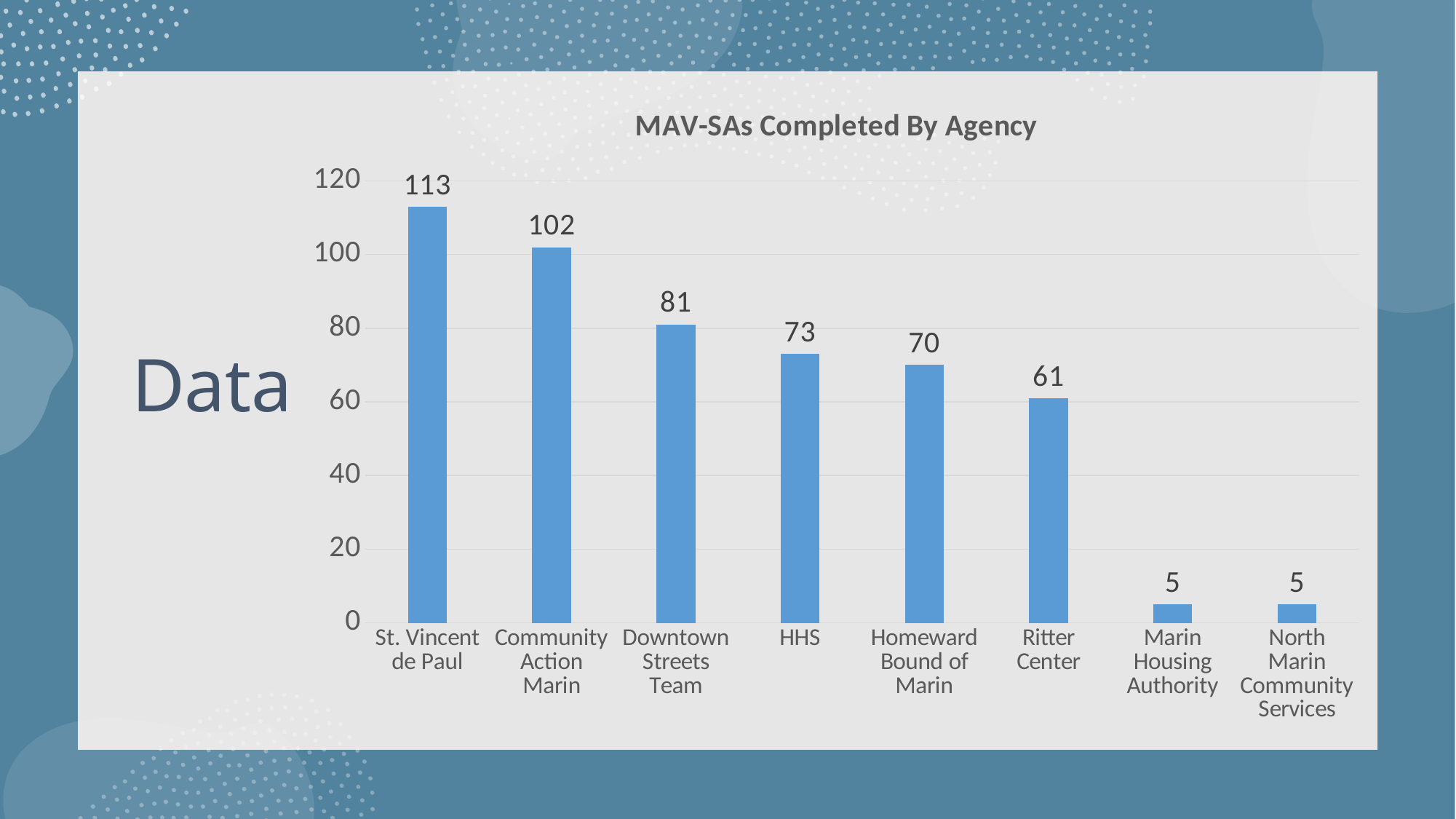
Which agency has the highest value? St. Vincent de Paul What kind of chart is this? bar chart Do the values rise or fall from left to right across the agencies? fall What is the difference between Community Action Marin and HHS? 29 How many agencies are shown on the chart? 8 Is the value for HHS greater or less than 80? less How many MAV-SAs did Downtown Streets Team complete? 81 What is the value for St. Vincent de Paul? 113 What is the value for Ritter Center? 61 What is the title of the chart? MAV-SAs Completed By Agency Which is larger, Homeward Bound of Marin or Ritter Center? Homeward Bound of Marin What is the difference between St. Vincent de Paul and Marin Housing Authority? 108